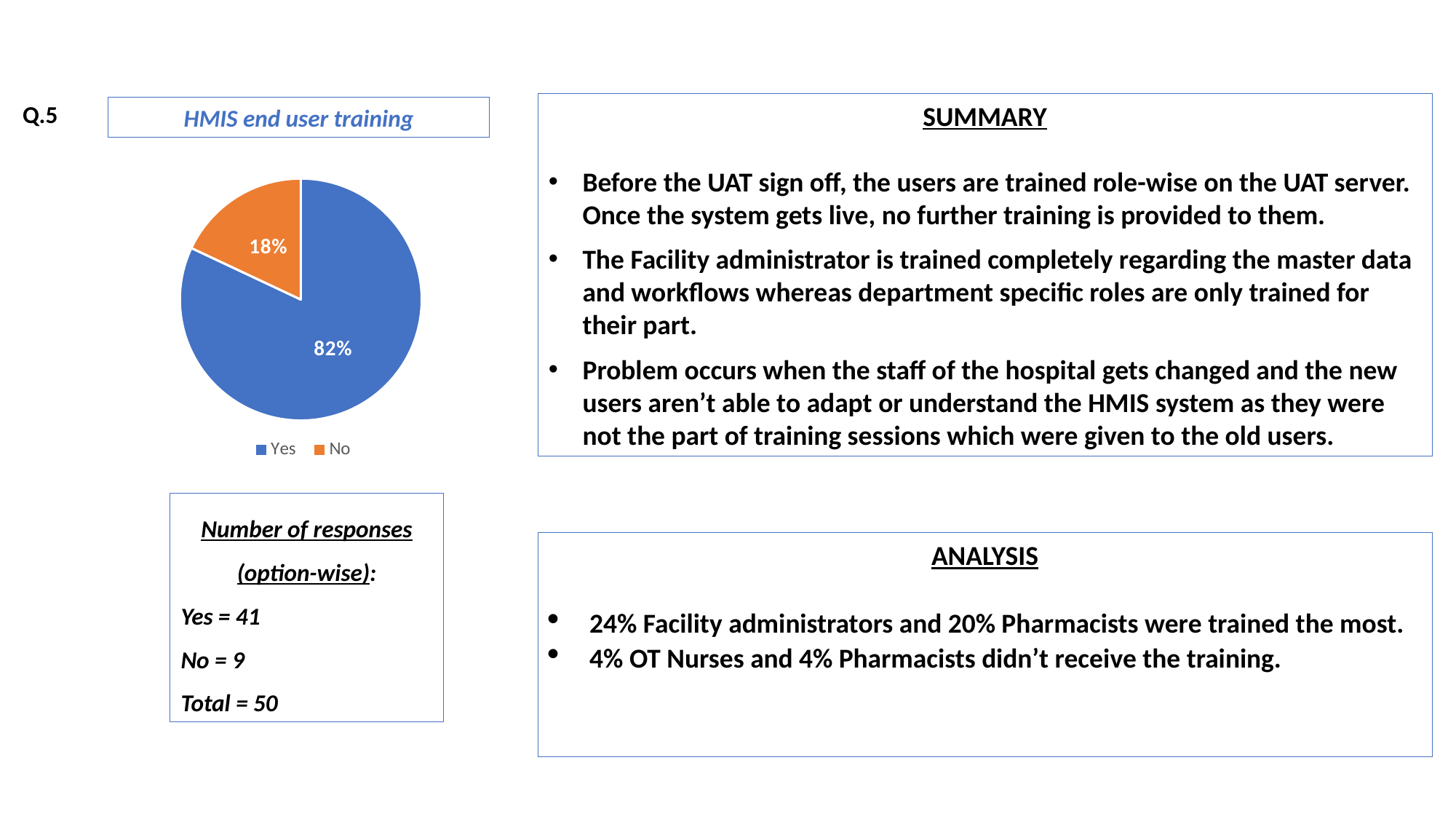
What colour is the No slice in the pie chart? orange What is the difference in percentage points between the Yes and No slices? 64 What share of the pie does the Yes slice represent? 82% What share of the pie does the No slice represent? 18% What type of chart is shown on the slide? pie chart What is the title of the chart? HMIS end user training Which is larger, the Yes slice or the No slice? Yes Is the share for Yes greater or less than 50%? greater Which slice of the pie is the largest? Yes How many entries does the chart legend list? 2 How many slices does the pie chart have? 2 Which slice of the pie is the smallest? No